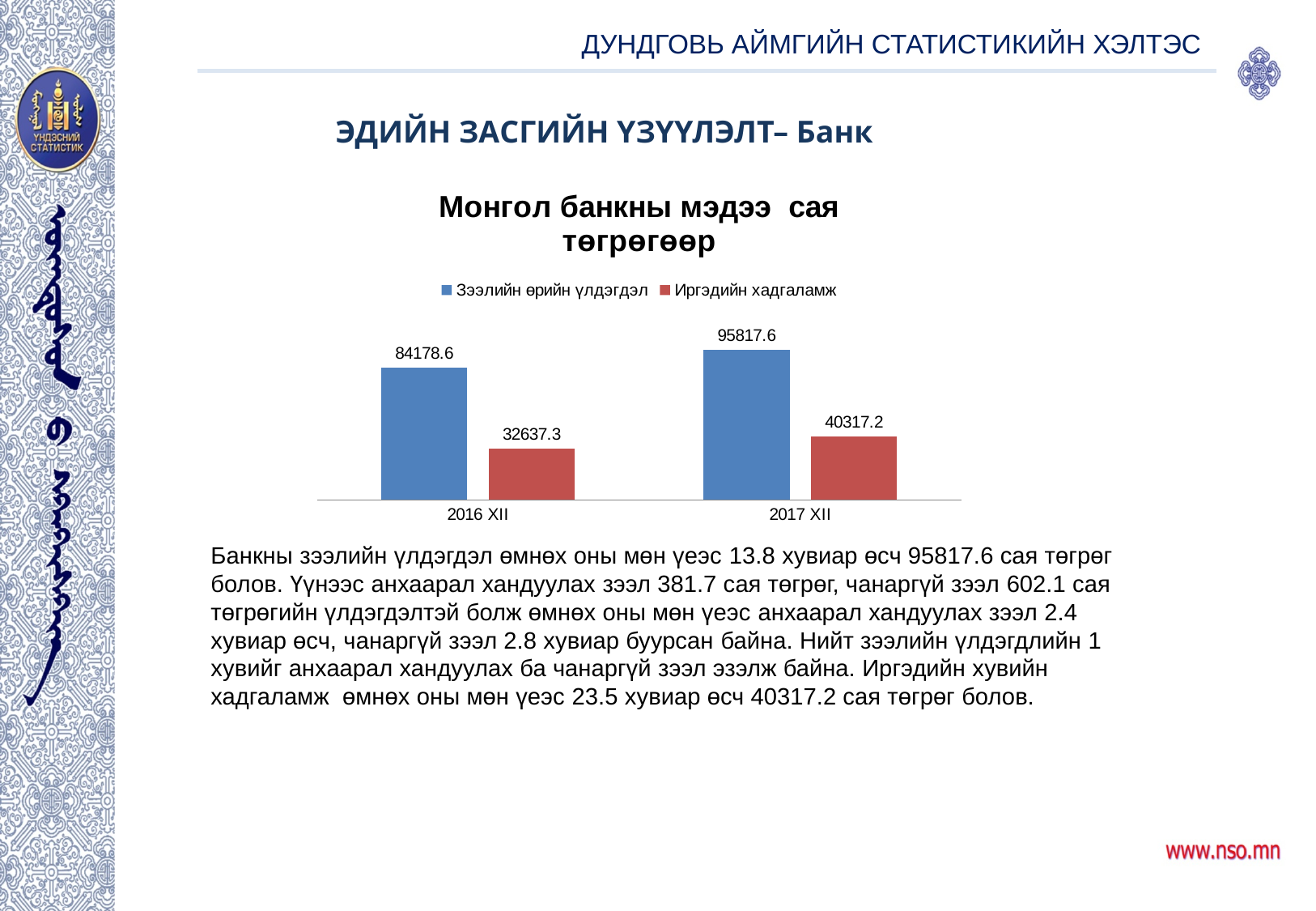
What is the difference between Зээлийн өрийн үлдэгдэл and Иргэдийн хадгаламж in 2017 XII? 55500.4 Which bar in the chart has the lowest value? Иргэдийн хадгаламж, 2016 XII What is the value of Зээлийн өрийн үлдэгдэл for 2017 XII? 95817.6 By how much did Зээлийн өрийн үлдэгдэл increase from 2016 XII to 2017 XII? 11639.0 How many series does the legend list? 2 Which is larger in 2016 XII: Зээлийн өрийн үлдэгдэл or Иргэдийн хадгаламж? Зээлийн өрийн үлдэгдэл What is the value of Иргэдийн хадгаламж for 2017 XII? 40317.2 What kind of chart is shown on the slide? Bar chart What is the value of Зээлийн өрийн үлдэгдэл for 2016 XII? 84178.6 What is the value of Иргэдийн хадгаламж for 2016 XII? 32637.3 Does Иргэдийн хадгаламж rise or fall from 2016 XII to 2017 XII? Rise Which period has the higher value for Зээлийн өрийн үлдэгдэл? 2017 XII